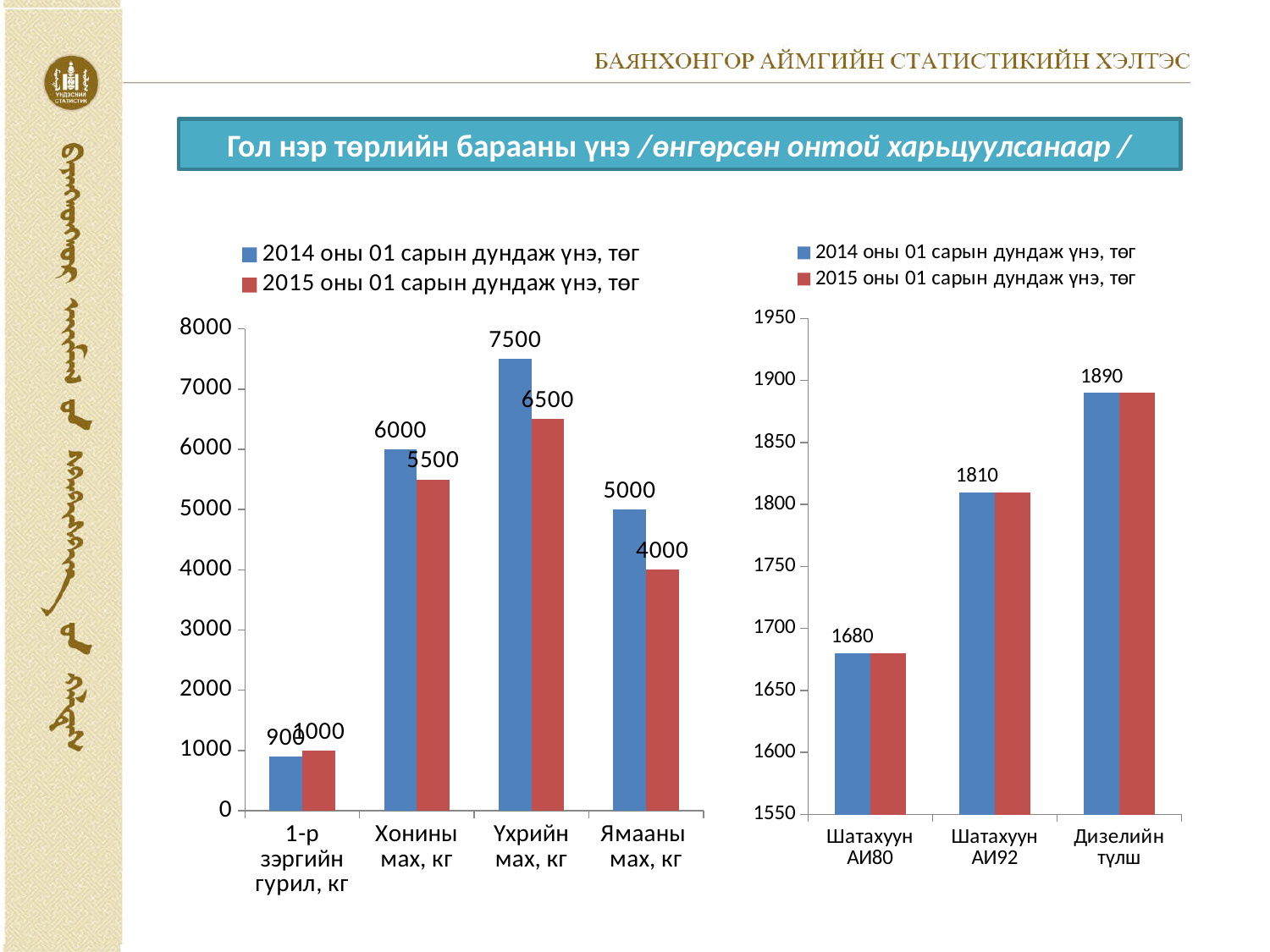
What kind of chart is the right chart? Bar chart In the right chart, what is the 2014 оны 01 сарын дундаж үнэ for Дизелийн түлш? 1890 In the left chart, which category has the highest 2014 оны 01 сарын дундаж үнэ? Үхрийн мах, кг In the left chart, what is the difference between the 2014 and 2015 values for Үхрийн мах, кг? 1000 In the left chart, what is the 2015 оны 01 сарын дундаж үнэ for Хонины мах, кг? 5500 How many categories are shown on the x axis of the left chart? 4 In the right chart, what is the 2014 оны 01 сарын дундаж үнэ for Шатахуун АИ80? 1680 In the left chart, what is the 2014 оны 01 сарын дундаж үнэ for Үхрийн мах, кг? 7500 In the left chart, what is the 2015 оны 01 сарын дундаж үнэ for Ямааны мах, кг? 4000 In the left chart, for 1-р зэргийн гурил, кг, which is larger: the 2014 value or the 2015 value? 2015 value How many series does the legend of the right chart list? 2 In the left chart, which category has the lowest 2015 оны 01 сарын дундаж үнэ? 1-р зэргийн гурил, кг